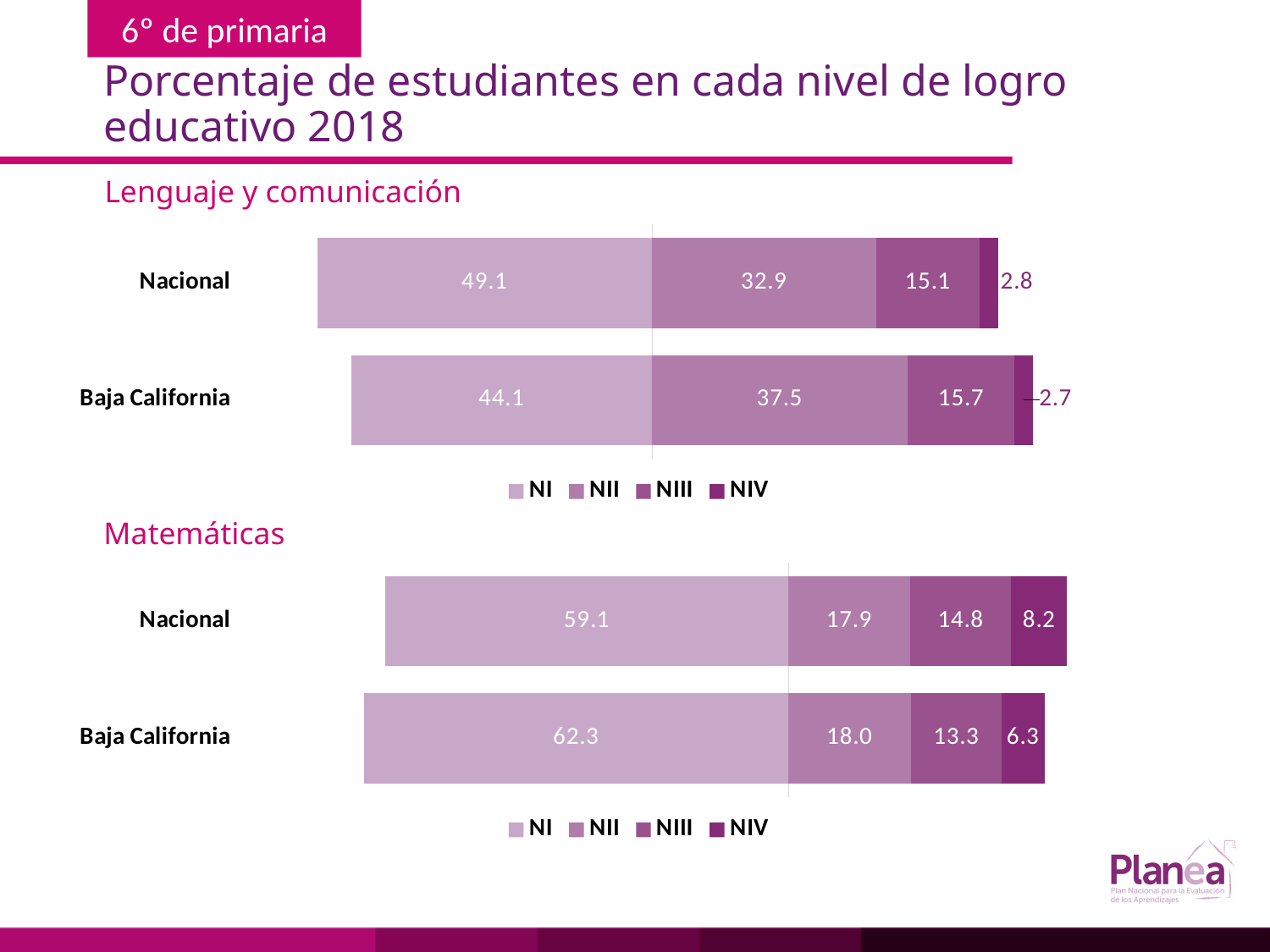
How many series does the legend of the Matemáticas chart list? 4 In the Lenguaje y comunicación chart, what is the NII value for Baja California? 37.5 In the Lenguaje y comunicación chart, what is the NI value for Nacional? 49.1 In the Matemáticas chart, what is the NIV value for Baja California? 6.3 What kind of chart is the Lenguaje y comunicación chart? Stacked bar chart In the Lenguaje y comunicación chart, what is the difference between the NI values for Nacional and Baja California? 5.0 In the Matemáticas chart, what is the NIII value for Nacional? 14.8 In the Matemáticas chart, what is the difference between the NIV values for Nacional and Baja California? 1.9 In the Lenguaje y comunicación chart, which series has the smallest value for Nacional? NIV In the Matemáticas chart, which category has the higher NI value, Nacional or Baja California? Baja California In the Matemáticas chart, what is the total of the stacked bar for Nacional? 100.0 In the Lenguaje y comunicación chart, which category has the higher NII value, Nacional or Baja California? Baja California